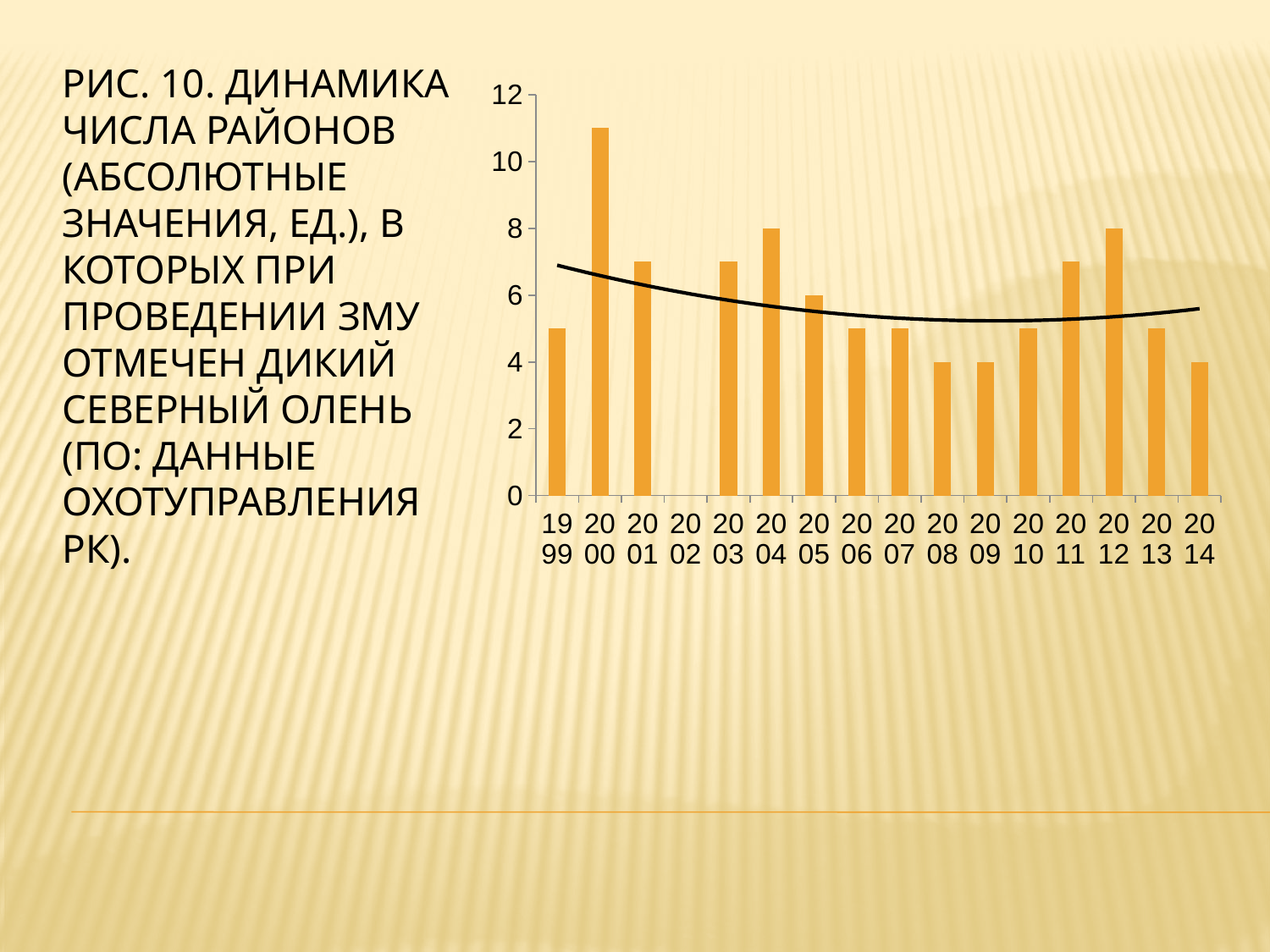
What is the difference between the values for 2012 and 2014? 4 What is the value for 2004? 8 Which is larger, the value for 2004 or the value for 2005? 2004 What kind of chart is shown on the slide? bar chart Is the value for 1999 greater or less than 6? less What is the value for 2014? 4 Is the value for 2000 greater or less than 10? greater How many years are shown on the x axis of the chart? 16 What is the value for 2012? 8 Does the black trend line fall or rise from 1999 to 2009? fall What is the value for 2005? 6 Which year has the highest bar in the chart? 2000